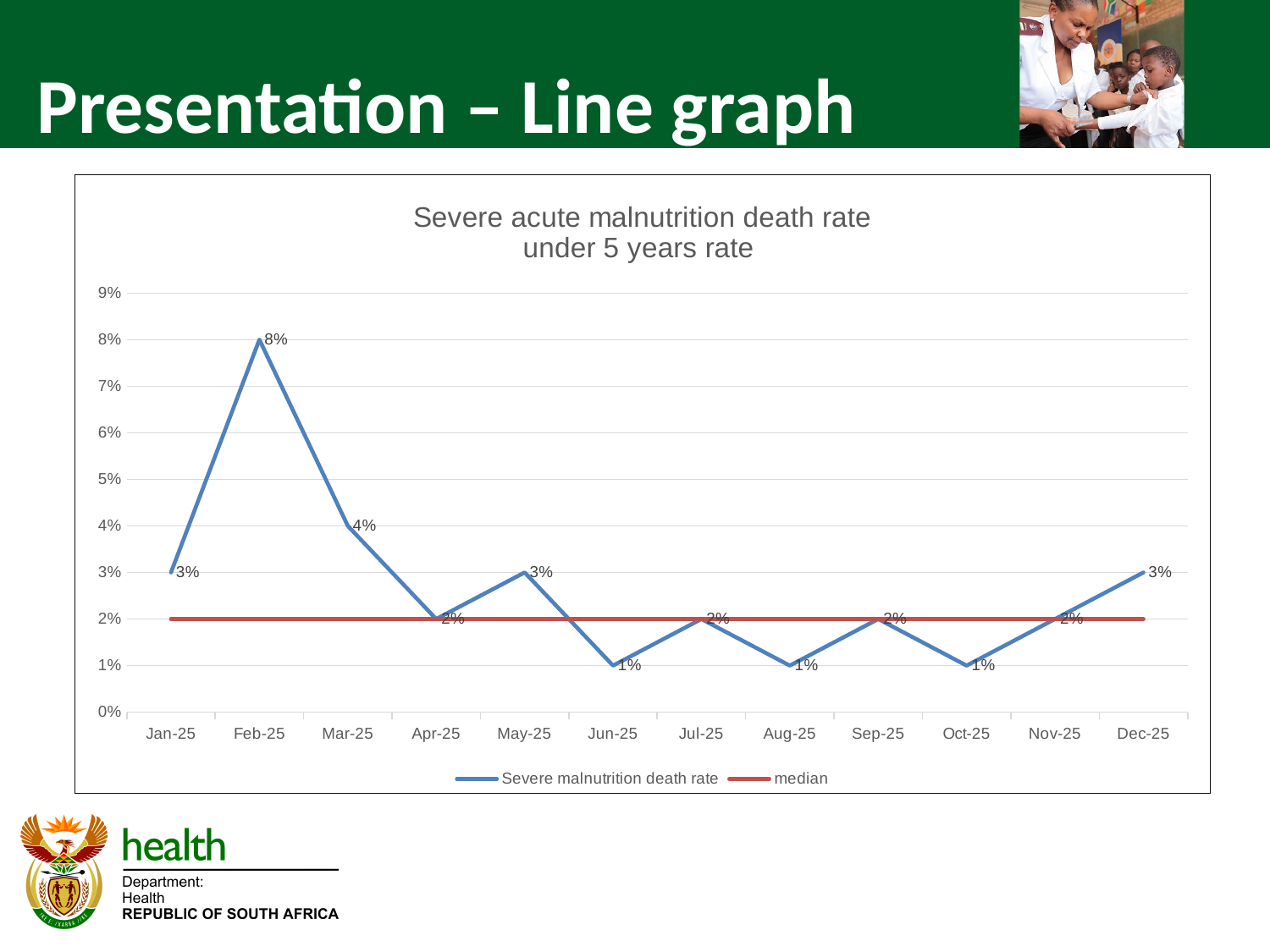
Which is larger, the severe malnutrition death rate in May-25 or in Jun-25? May-25 What is the difference between the severe malnutrition death rate in Feb-25 and Mar-25? 4% Does the severe malnutrition death rate rise or fall from Feb-25 to Apr-25? Fall What is the severe malnutrition death rate for Mar-25? 4% How many months are plotted on the x axis? 12 What is the severe malnutrition death rate for Feb-25? 8% Which month has the highest severe malnutrition death rate? Feb-25 What is the title of the chart? Severe acute malnutrition death rate under 5 years rate How many series does the legend list? 2 What kind of chart is shown on the slide? Line chart What is the severe malnutrition death rate for Dec-25? 3% Is the severe malnutrition death rate for Feb-25 greater or less than 5%? greater